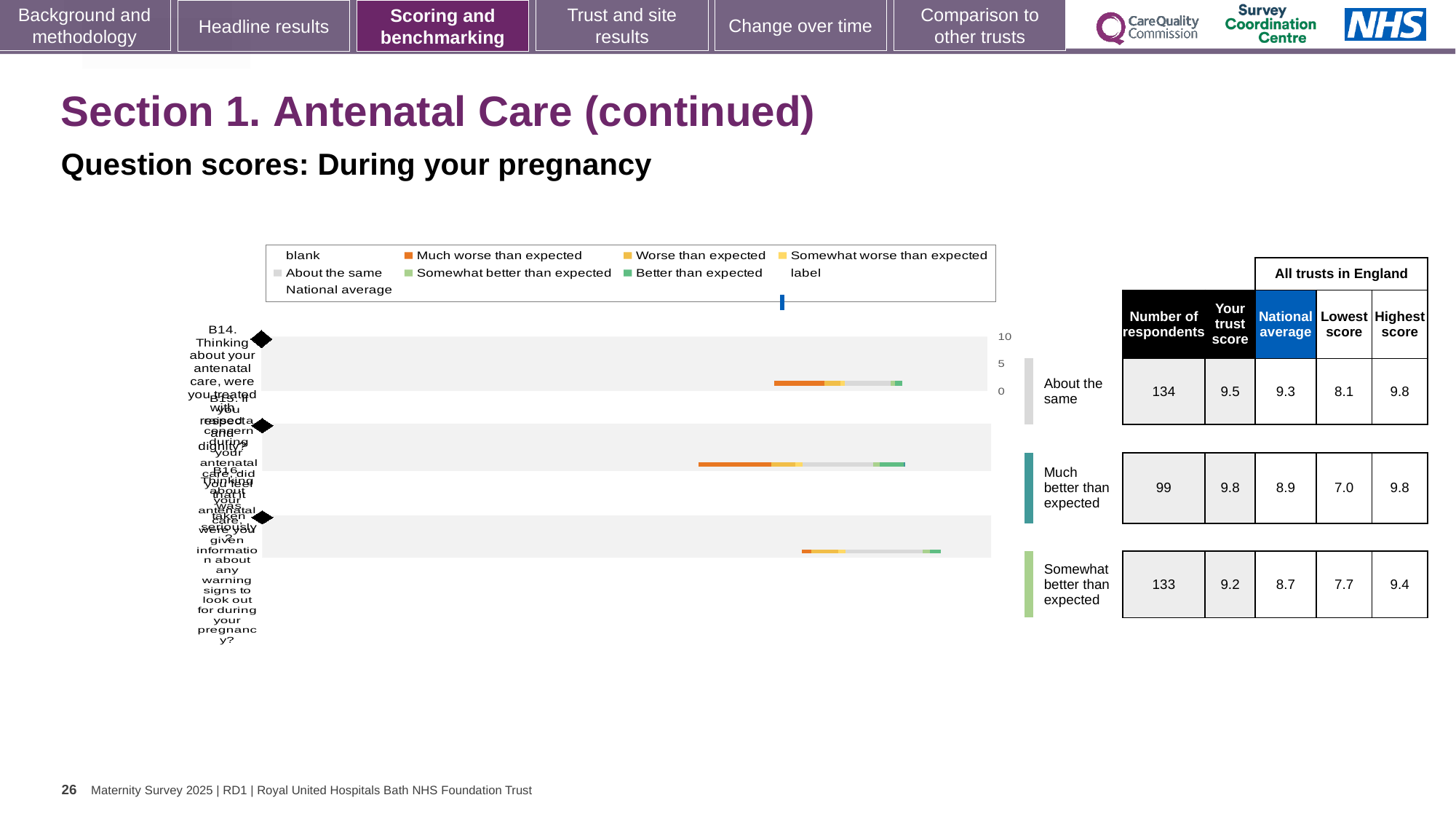
In the table beside the chart, what is the difference between 'Your trust score' and 'National average' for the 'About the same' row? 0.2 In the table beside the chart, which rating row has the smallest number of respondents? Much better than expected In the table beside the chart, what is the 'Your trust score' for the row rated 'Much better than expected'? 9.8 In the table beside the chart, what is the lowest score for the 'Somewhat better than expected' row? 7.7 What is the highest tick value shown on the chart's score axis? 10 How many entries does the chart legend list? 9 In the table beside the chart, which rating row has the highest 'Your trust score'? Much better than expected In the table beside the chart, which is larger: the national average for the 'Much better than expected' row or for the 'Somewhat better than expected' row? Much better than expected What colour does the legend use for 'Much worse than expected'? orange In the table beside the chart, what is the number of respondents for the row rated 'About the same'? 134 How many question rows (bars) are plotted in the chart? 3 What kind of chart is shown on the slide? bar chart